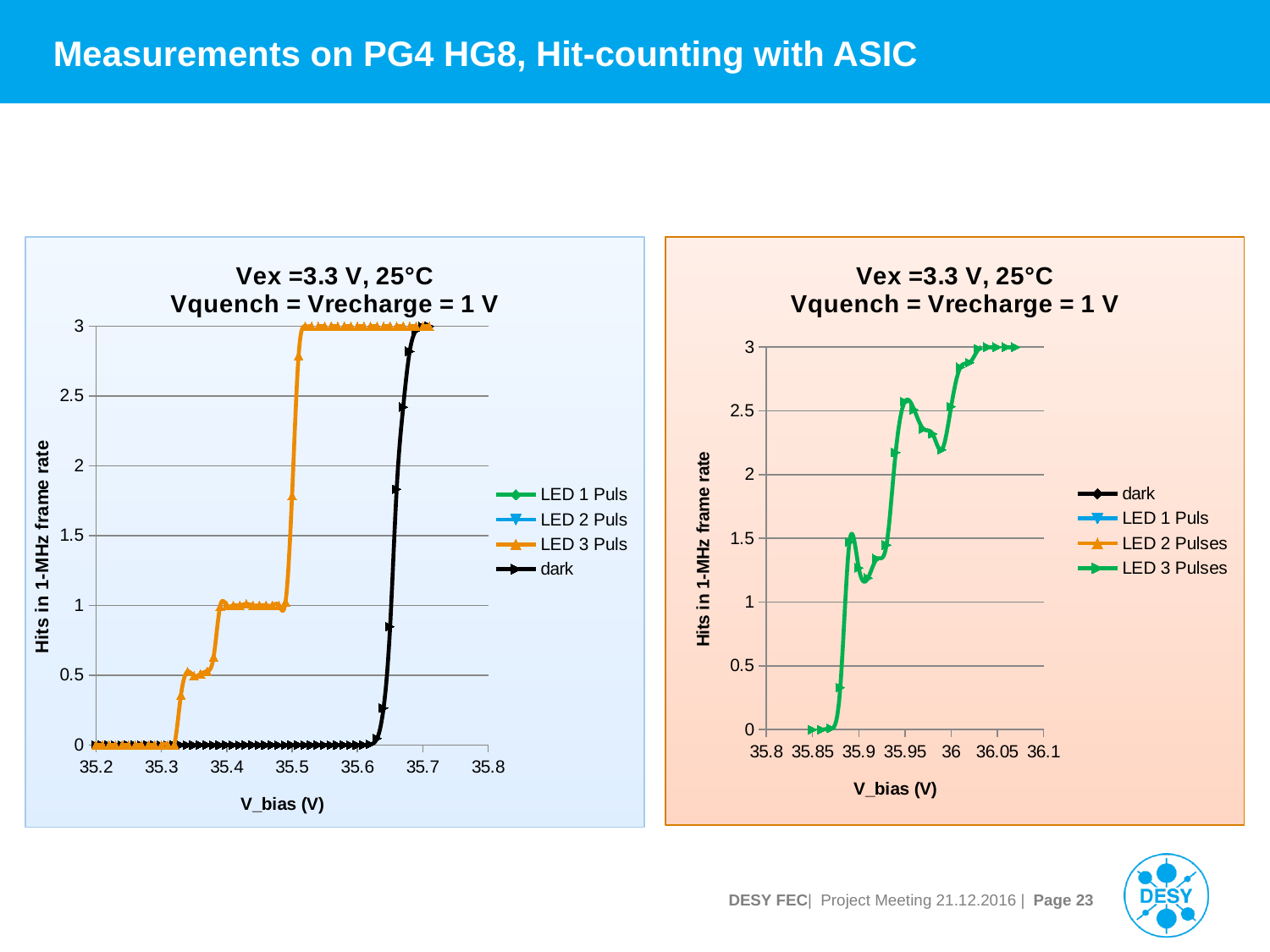
On the left chart, what value does LED 3 Puls reach at V_bias 35.7 V? 3 On the right chart, does the LED 3 Pulses series overall rise or fall as V_bias increases? rise What is the y-axis title of the left chart? Hits in 1-MHz frame rate On the left chart, which series has the larger value at V_bias 35.6 V, LED 3 Puls or dark? LED 3 Puls What type of chart is the left chart? line chart How many series does the legend of the right chart list? 4 On the right chart, is the value of LED 3 Pulses at V_bias 35.85 V greater or less than 0.5? less On the right chart, is the value of LED 3 Pulses at V_bias 36.05 V greater or less than 2.5? greater On the left chart, is the value of LED 3 Puls at V_bias 35.6 V greater or less than 2.5? greater How many series does the legend of the left chart list? 4 What is the x-axis title of the right chart? V_bias (V)